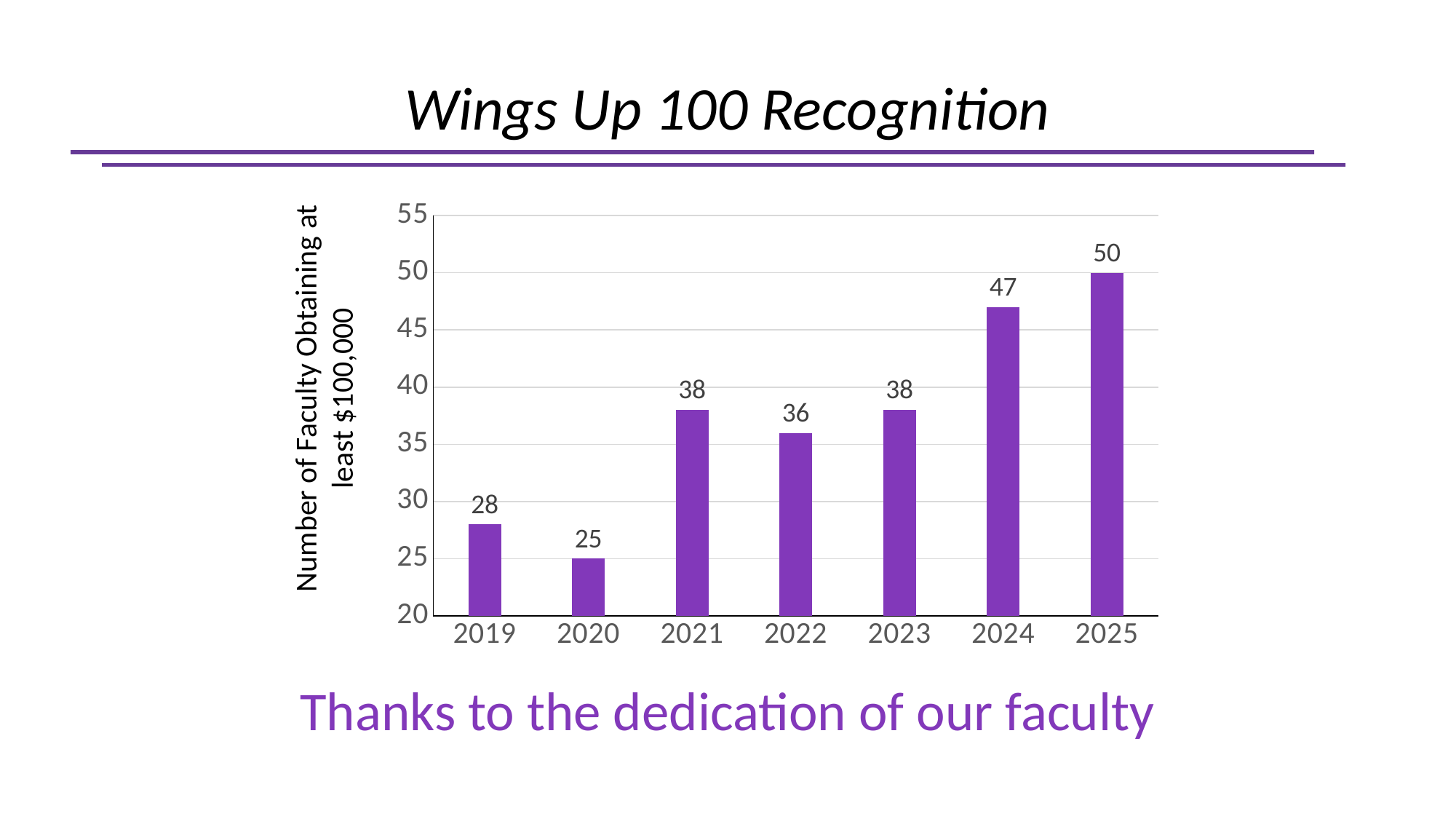
How many years are shown on the x axis of the chart? 7 What is the difference between the values for 2021 and 2022? 2 What is the label on the vertical axis of the chart? Number of Faculty Obtaining at least $100,000 What is the value shown for 2024? 47 Which is larger, the value for 2020 or the value for 2023? 2023 Which year has the lowest value on the chart? 2020 What is the value shown for 2022? 36 What is the difference between the values for 2025 and 2019? 22 Which year has the highest number of faculty obtaining at least $100,000? 2025 Is the value for 2024 greater or less than 45? greater What is the number of faculty obtaining at least $100,000 in 2019? 28 What kind of chart is shown on the slide? bar chart